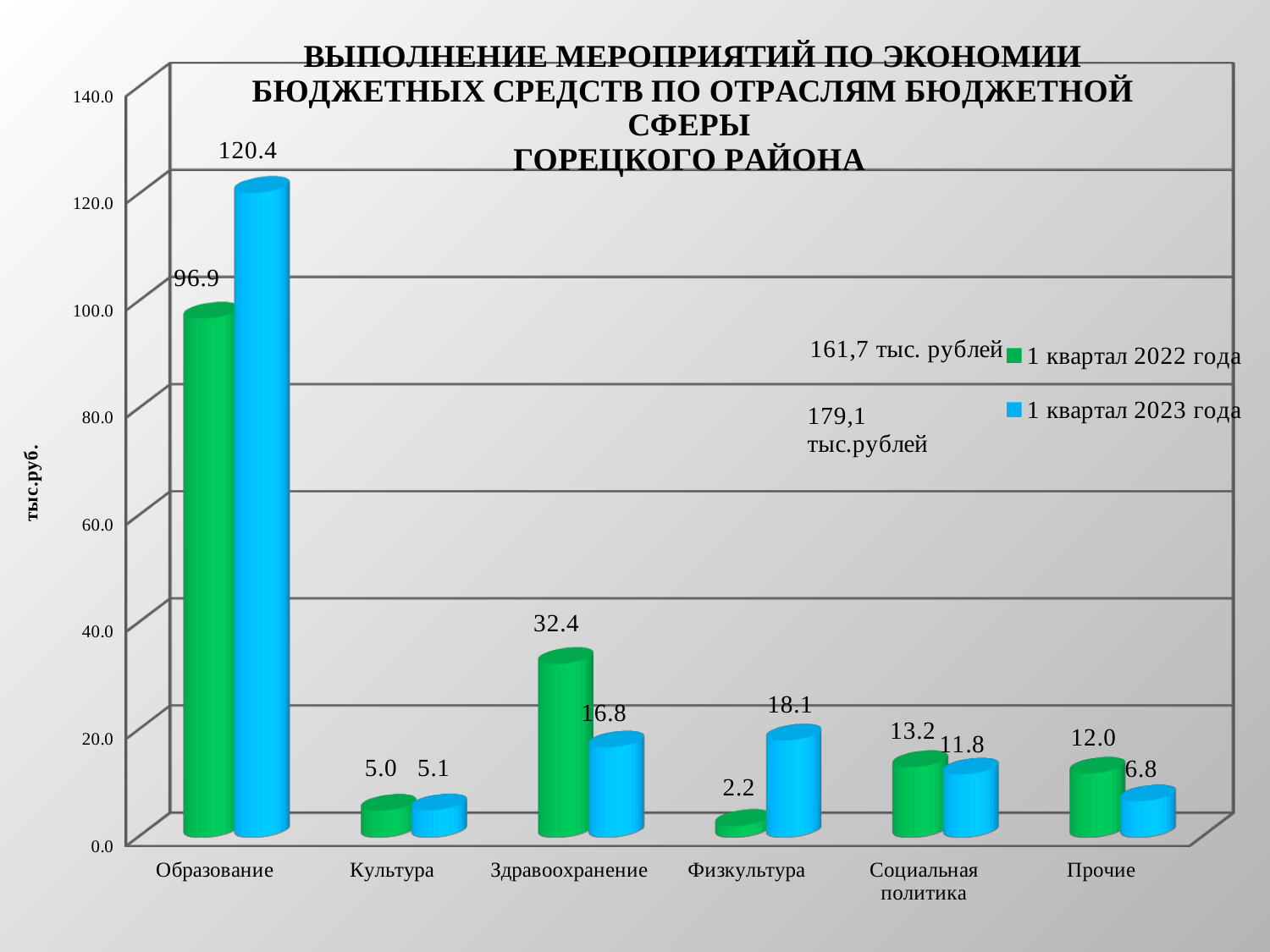
What is the difference between the 1 квартал 2023 года and 1 квартал 2022 года values for Образование? 23.5 What is the value for Здравоохранение in the 1 квартал 2022 года series? 32.4 How many series does the legend list? 2 Which category has the lowest value in the 1 квартал 2022 года series? Физкультура Which is larger for Здравоохранение: the 1 квартал 2022 года value or the 1 квартал 2023 года value? 1 квартал 2022 года What is the y-axis label of the chart? тыс.руб. Is the value for Образование in the 1 квартал 2022 года series greater or less than 100.0? less What kind of chart is shown on the slide? Bar chart Which category has the highest value in the 1 квартал 2023 года series? Образование How many categories are shown on the x axis? 6 What is the value for Физкультура in the 1 квартал 2022 года series? 2.2 What is the value for Образование in the 1 квартал 2023 года series? 120.4